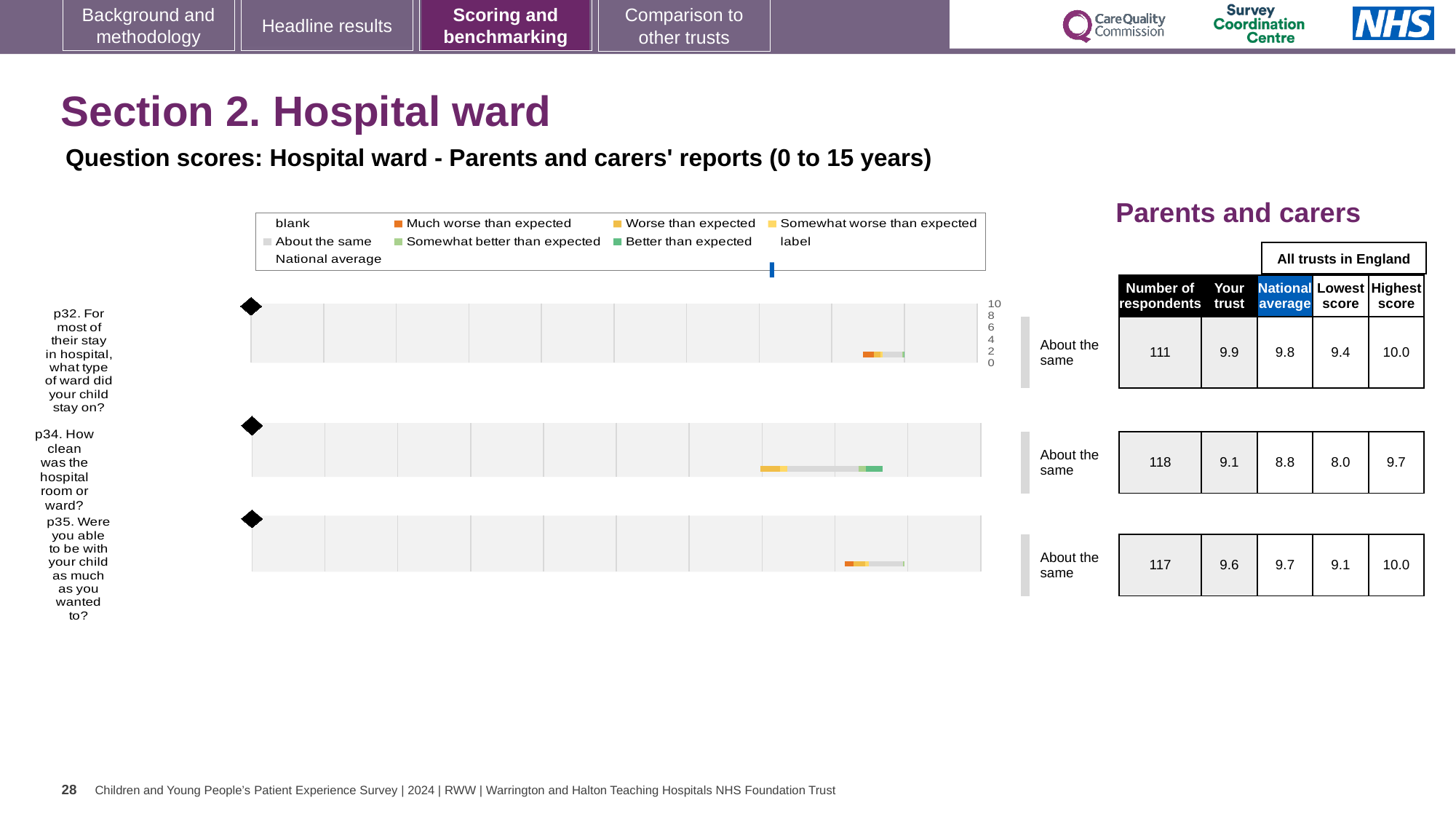
What is the national average score for question p35 (were you able to be with your child as much as you wanted to)? 9.7 What kind of chart is used to show the question scores? Bar chart What benchmark category is shown next to question p34? About the same What is the lowest score among all trusts in England for question p34? 8.0 How many questions are plotted on the chart? 3 For question p34, what is the difference between the 'Your trust' score and the national average? 0.3 Which question has the highest 'Your trust' score? p32 Which question has the lowest national average score? p34 How many respondents are shown for question p34 (How clean was the hospital room or ward)? 118 For question p35, which is larger: the 'Your trust' score or the national average? National average What is the highest score among all trusts in England for question p32? 10.0 What is the 'Your trust' score for question p32 (what type of ward did your child stay on)? 9.9